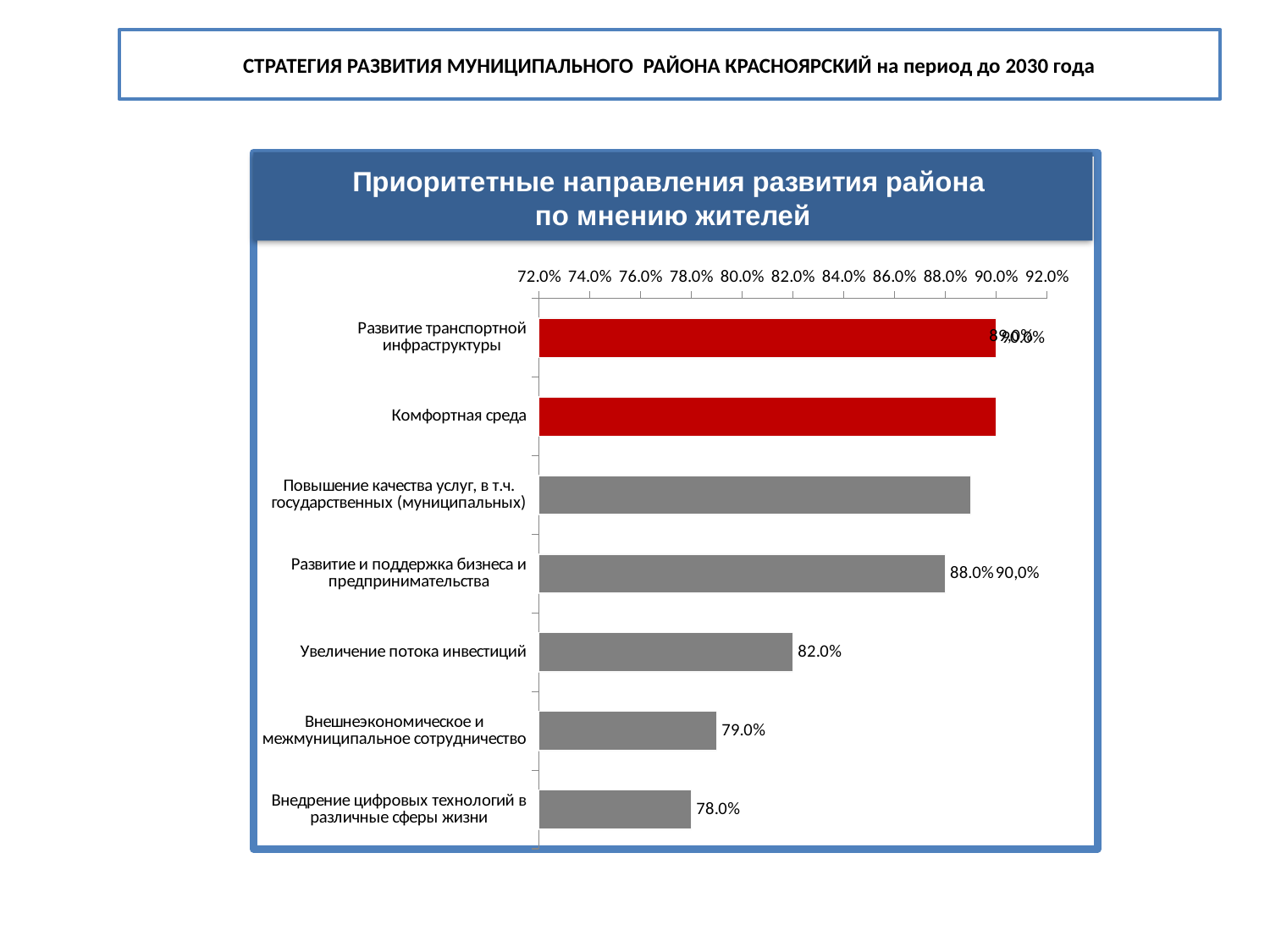
Is the value for Комфортная среда greater or less than 86.0%? greater Which is larger: the value for Увеличение потока инвестиций or the value for Внешнеэкономическое и межмуниципальное сотрудничество? Увеличение потока инвестиций What kind of chart is shown on the slide? bar chart Is the value for Внешнеэкономическое и межмуниципальное сотрудничество greater or less than 80.0%? less What is the value for Внедрение цифровых технологий в различные сферы жизни? 78.0% Is the value for Повышение качества услуг, в т.ч. государственных (муниципальных) greater or less than 84.0%? greater What is the value for Увеличение потока инвестиций? 82.0% What is the title of the chart? Приоритетные направления развития района по мнению жителей How many categories are shown in the chart? 7 Which category has the lowest value? Внедрение цифровых технологий в различные сферы жизни What is the difference between the values for Увеличение потока инвестиций and Внедрение цифровых технологий в различные сферы жизни? 4.0% What is the value for Внешнеэкономическое и межмуниципальное сотрудничество? 79.0%